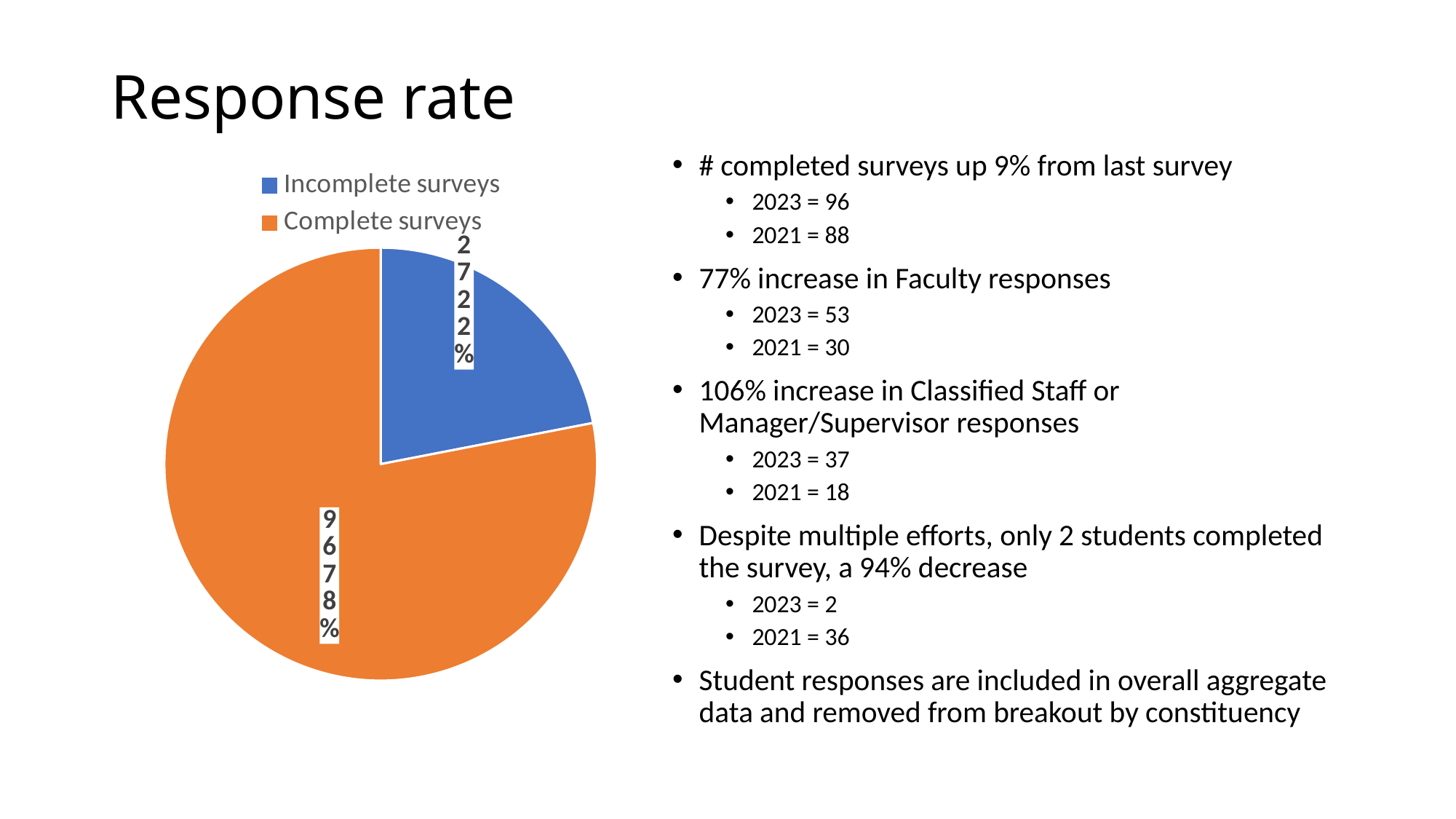
How many slices does the pie chart have? 2 What is the difference between the number of Complete surveys and Incomplete surveys in the pie chart? 69 Which slice of the pie chart is larger, Complete surveys or Incomplete surveys? Complete surveys What share of the pie do Complete surveys represent? 78% What kind of chart is shown on the slide? pie chart What is the number of Complete surveys shown on the pie chart? 96 What colour is the Incomplete surveys slice in the pie chart? blue What share of the pie do Incomplete surveys represent? 22% What is the number of Incomplete surveys shown on the pie chart? 27 How many entries does the legend of the pie chart list? 2 What colour is the Complete surveys slice in the pie chart? orange Which category has the smallest slice in the pie chart? Incomplete surveys